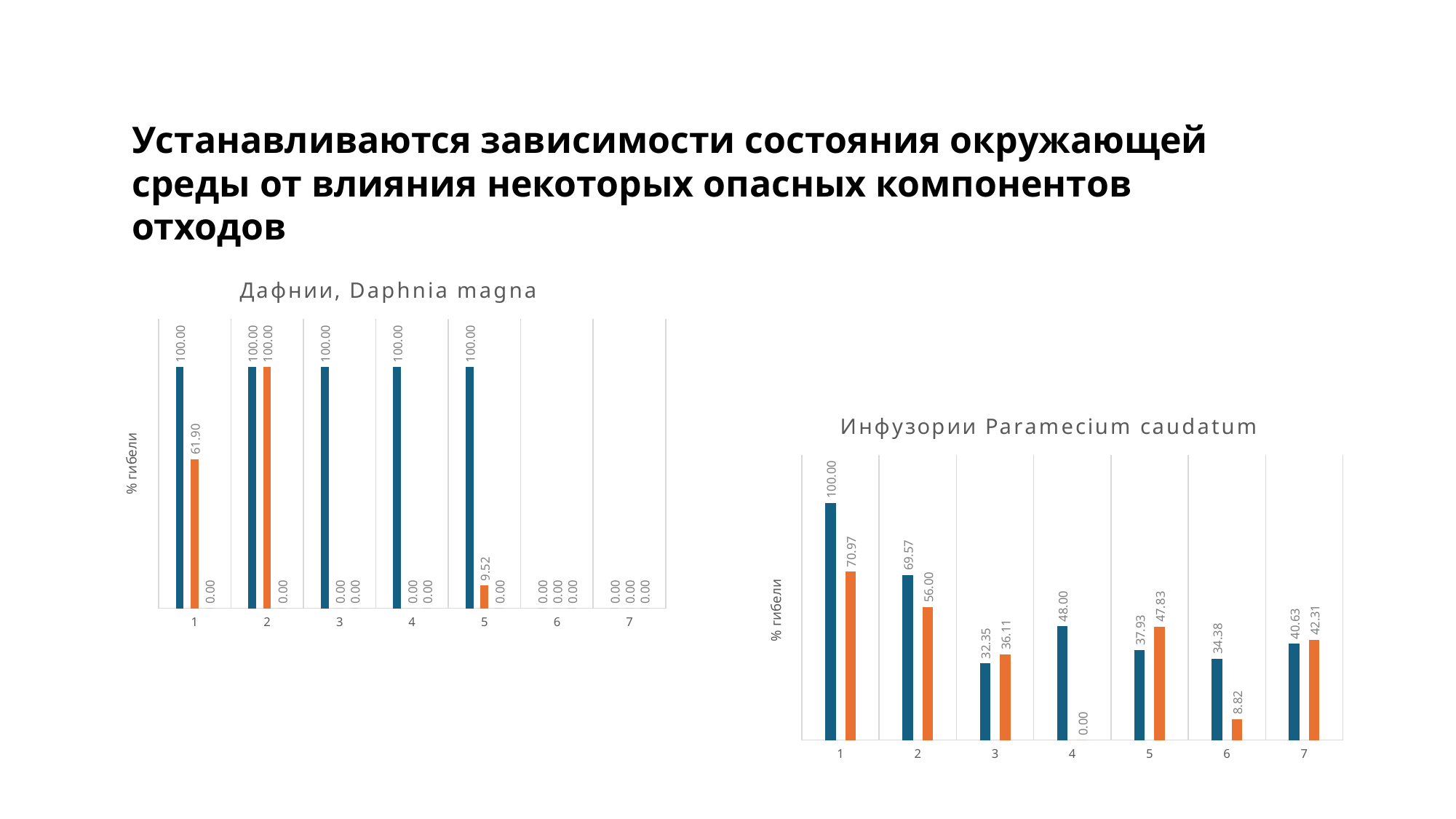
In the chart titled 'Дафнии, Daphnia magna', what is the value of the orange bar for category 1? 61.90 In the chart titled 'Дафнии, Daphnia magna', what is the value of the orange bar for category 5? 9.52 What is the y-axis label of the chart titled 'Инфузории Paramecium caudatum'? % гибели In the chart titled 'Инфузории Paramecium caudatum', which category has the lowest orange bar value? 4 What type of chart is the one titled 'Дафнии, Daphnia magna'? Bar chart In the chart titled 'Инфузории Paramecium caudatum', what is the value of the orange bar for category 6? 8.82 How many categories are shown on the x axis of the chart titled 'Инфузории Paramecium caudatum'? 7 In the chart titled 'Инфузории Paramecium caudatum', what is the difference between the blue and orange bars for category 1? 29.03 In the chart titled 'Инфузории Paramecium caudatum', what is the value of the blue bar for category 1? 100.00 In the chart titled 'Инфузории Paramecium caudatum', what is the difference between the orange bar for category 2 and the orange bar for category 3? 19.89 In the chart titled 'Инфузории Paramecium caudatum', what is the value of the orange bar for category 3? 36.11 In the chart titled 'Инфузории Paramecium caudatum', which is larger: the blue bar for category 4 or the blue bar for category 5? Category 4